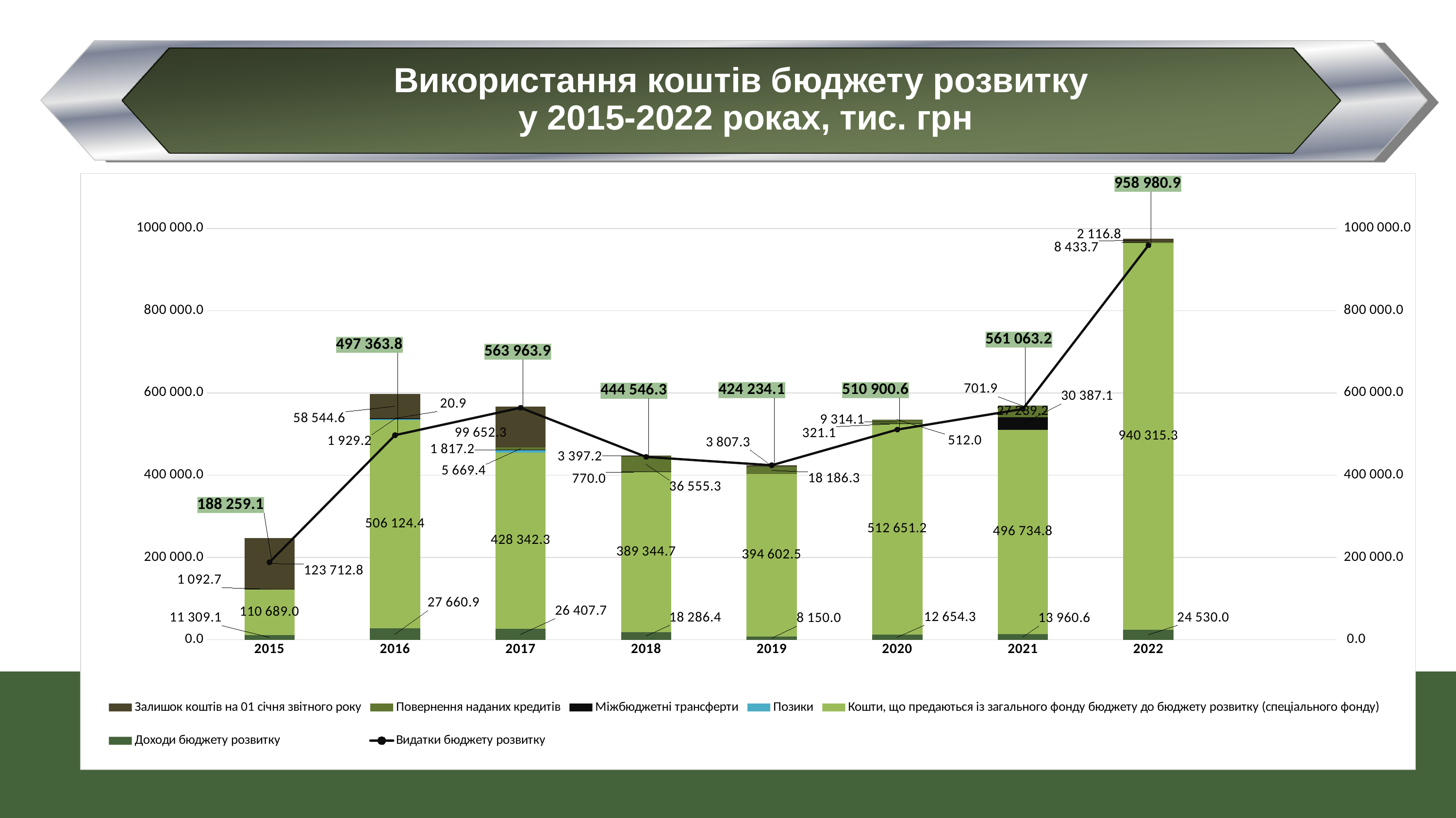
How many series does the legend list? 7 What kind of chart is shown on the slide? Combined stacked bar and line chart What is the difference in Видатки бюджету розвитку between 2022 and 2021? 397 917.7 Which year has the larger Видатки бюджету розвитку, 2017 or 2018? 2017 In which year is Видатки бюджету розвитку highest? 2022 How many years are shown on the x axis? 8 What is the value of Доходи бюджету розвитку for 2016? 27 660.9 In which year is Видатки бюджету розвитку lowest? 2015 What is the value of Видатки бюджету розвитку for 2015? 188 259.1 What is the value of Видатки бюджету розвитку for 2022? 958 980.9 Is the total height of the stacked bar for 2022 greater or less than 800 000.0? greater What is the value of Кошти, що предаються із загального фонду бюджету до бюджету розвитку for 2022? 940 315.3